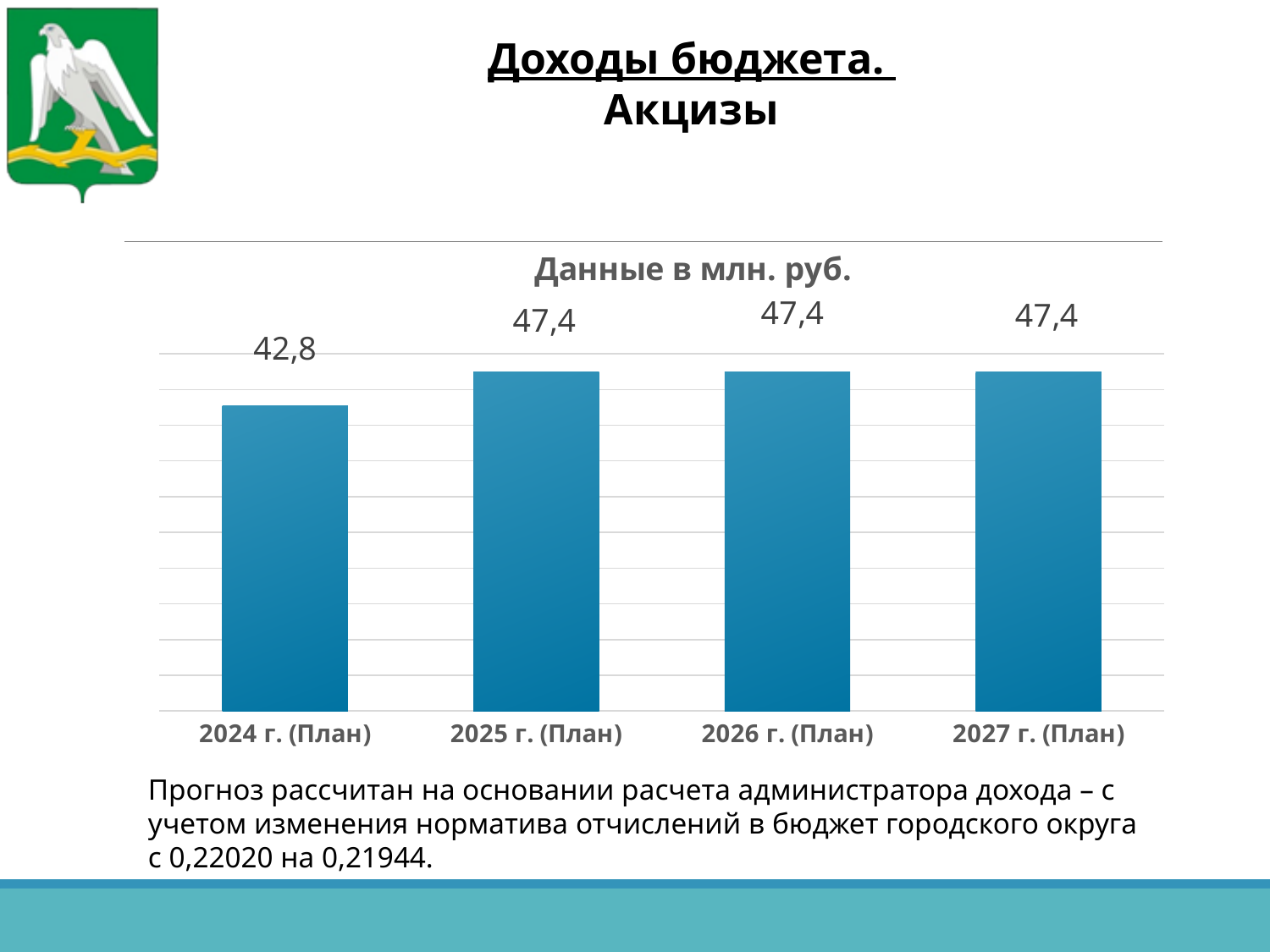
Are the values for 2025, 2026 and 2027 г. (План) the same or different? the same Which is larger, the value for 2024 г. (План) or the value for 2026 г. (План)? 2026 г. (План) What kind of chart is shown on the slide? bar chart What is the value for 2027 г. (План)? 47,4 How many categories are shown on the x axis? 4 Do the values rise or fall from 2024 г. (План) to 2025 г. (План)? rise What is the value for 2024 г. (План)? 42,8 What is the difference between the values for 2025 г. (План) and 2024 г. (План)? 4,6 Which category has the lowest value? 2024 г. (План) What colour are the bars in the chart? blue What is the title of the chart? Данные в млн. руб. What is the value for 2025 г. (План)? 47,4